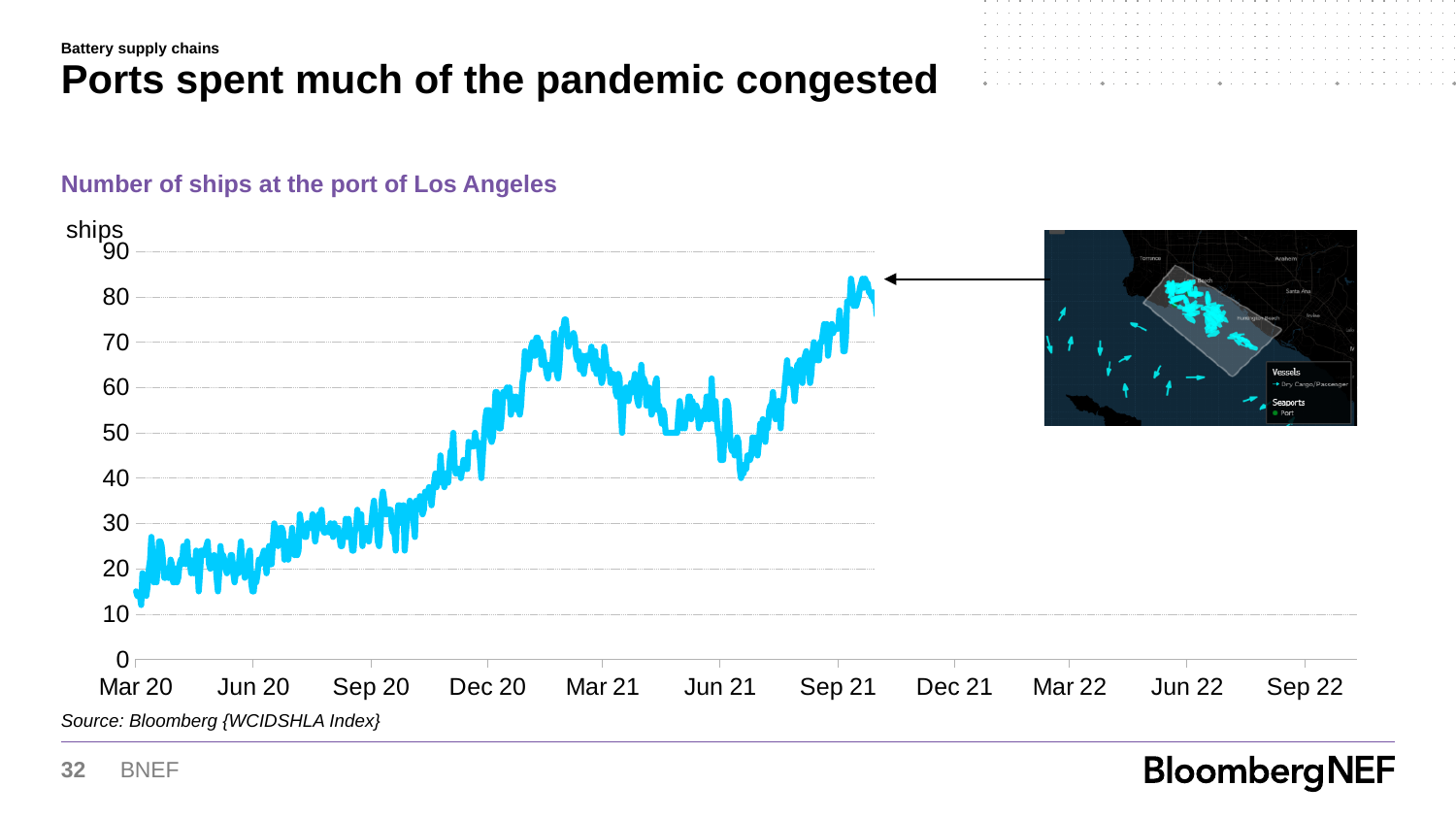
What is the title of the chart? Number of ships at the port of Los Angeles What unit is shown on the y axis of the chart? ships How many date labels are shown on the x axis? 11 Is the peak number of ships around Sep 21 greater or less than 80? greater Does the number of ships generally rise or fall between Mar 20 and Sep 21? rise Is the number of ships at the start of the series in Mar 20 greater or less than 20? less Around which x-axis label is the number of ships at its lowest? Mar 20 Around which x-axis label does the number of ships reach its highest point? Sep 21 What kind of chart is shown on the slide? Line chart Is the number of ships around Dec 20 greater or less than 30? greater